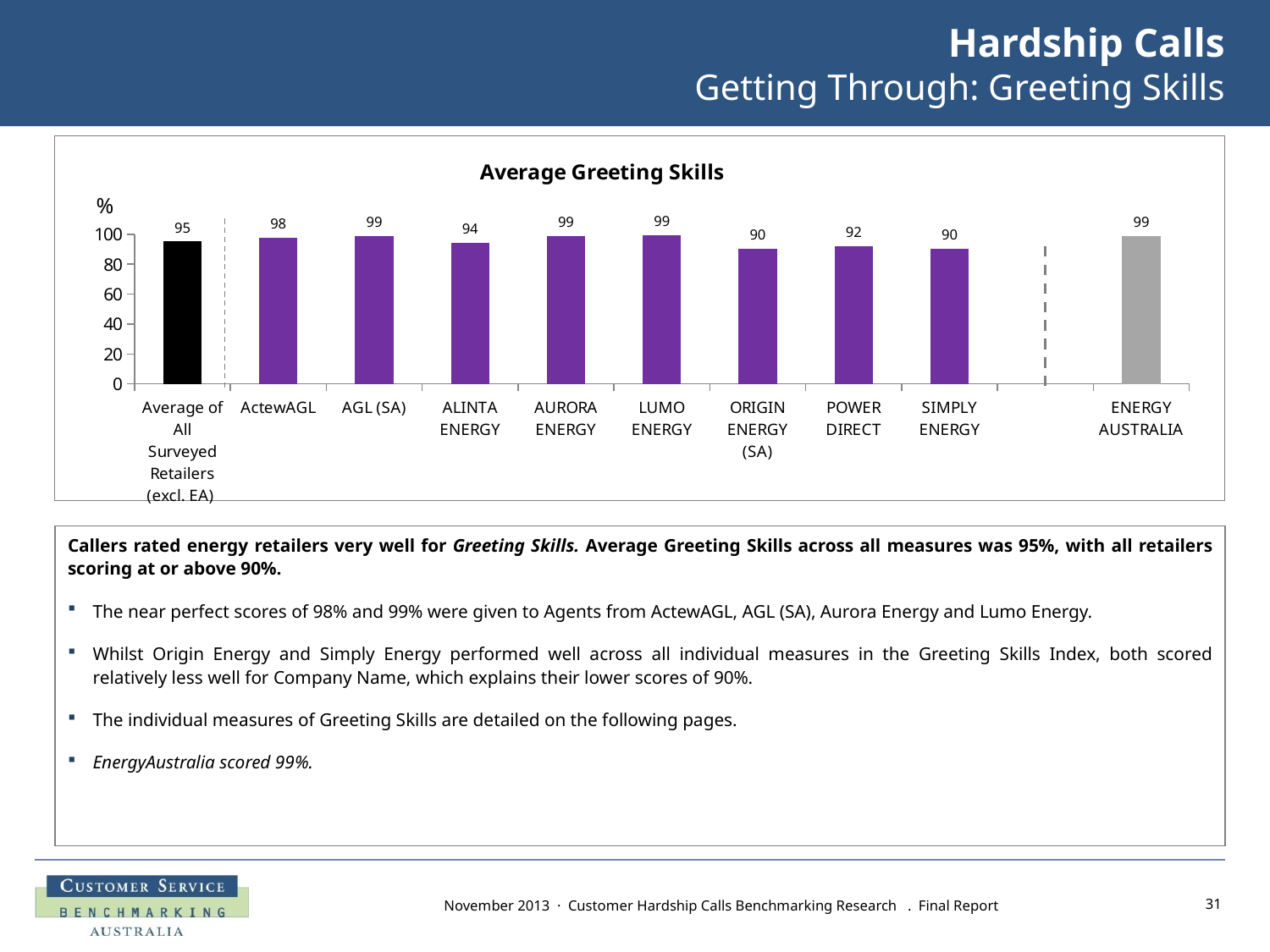
How many bars are shown in the Average Greeting Skills chart? 10 What is the value for the Average of All Surveyed Retailers (excl. EA) in the Average Greeting Skills chart? 95 What is the value for POWER DIRECT in the Average Greeting Skills chart? 92 What is the lowest value shown in the Average Greeting Skills chart? 90 What is the value for ActewAGL in the Average Greeting Skills chart? 98 Which has a higher value in the Average Greeting Skills chart, ActewAGL or SIMPLY ENERGY? ActewAGL What is the title of the chart on the slide? Average Greeting Skills What is the value for ENERGY AUSTRALIA in the Average Greeting Skills chart? 99 What is the value for ALINTA ENERGY in the Average Greeting Skills chart? 94 What is the difference between the values for AGL (SA) and ORIGIN ENERGY (SA) in the Average Greeting Skills chart? 9 Is the value for ORIGIN ENERGY (SA) in the Average Greeting Skills chart greater or less than 80? greater What kind of chart is the Average Greeting Skills chart? Bar chart